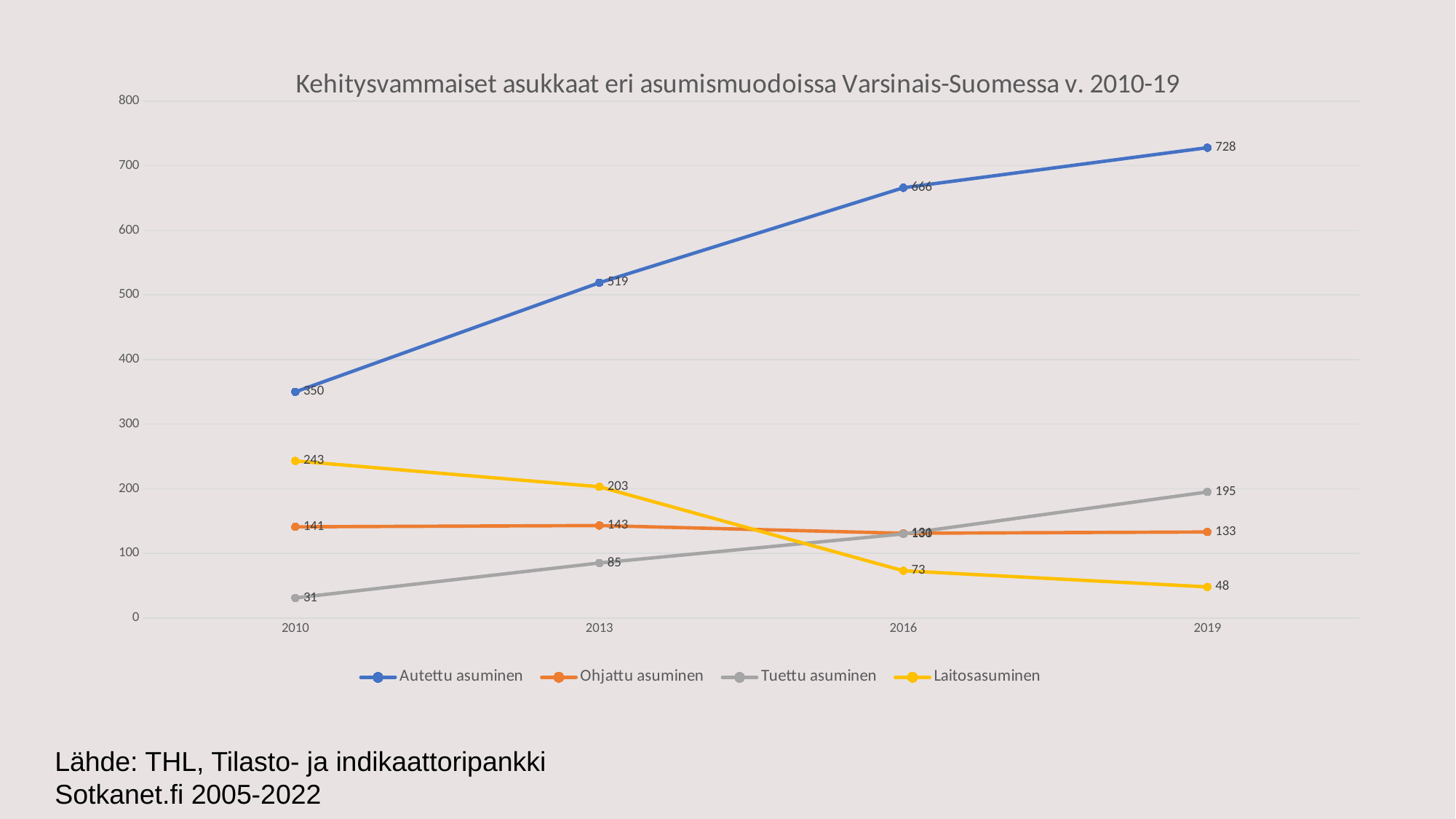
Which is larger in 2016: Autettu asuminen or Laitosasuminen? Autettu asuminen What kind of chart is shown on the slide? line chart What is the difference between the Autettu asuminen values in 2019 and 2010? 378 What is the value for Ohjattu asuminen in 2019? 133 How many series does the legend list? 4 What is the value for Autettu asuminen in 2019? 728 What is the value for Laitosasuminen in 2010? 243 Which series has the highest value in 2019? Autettu asuminen How many years are shown on the x axis? 4 What is the value for Tuettu asuminen in 2013? 85 Which series has the lowest value in 2010? Tuettu asuminen Does the value for Laitosasuminen rise or fall from 2010 to 2019? fall